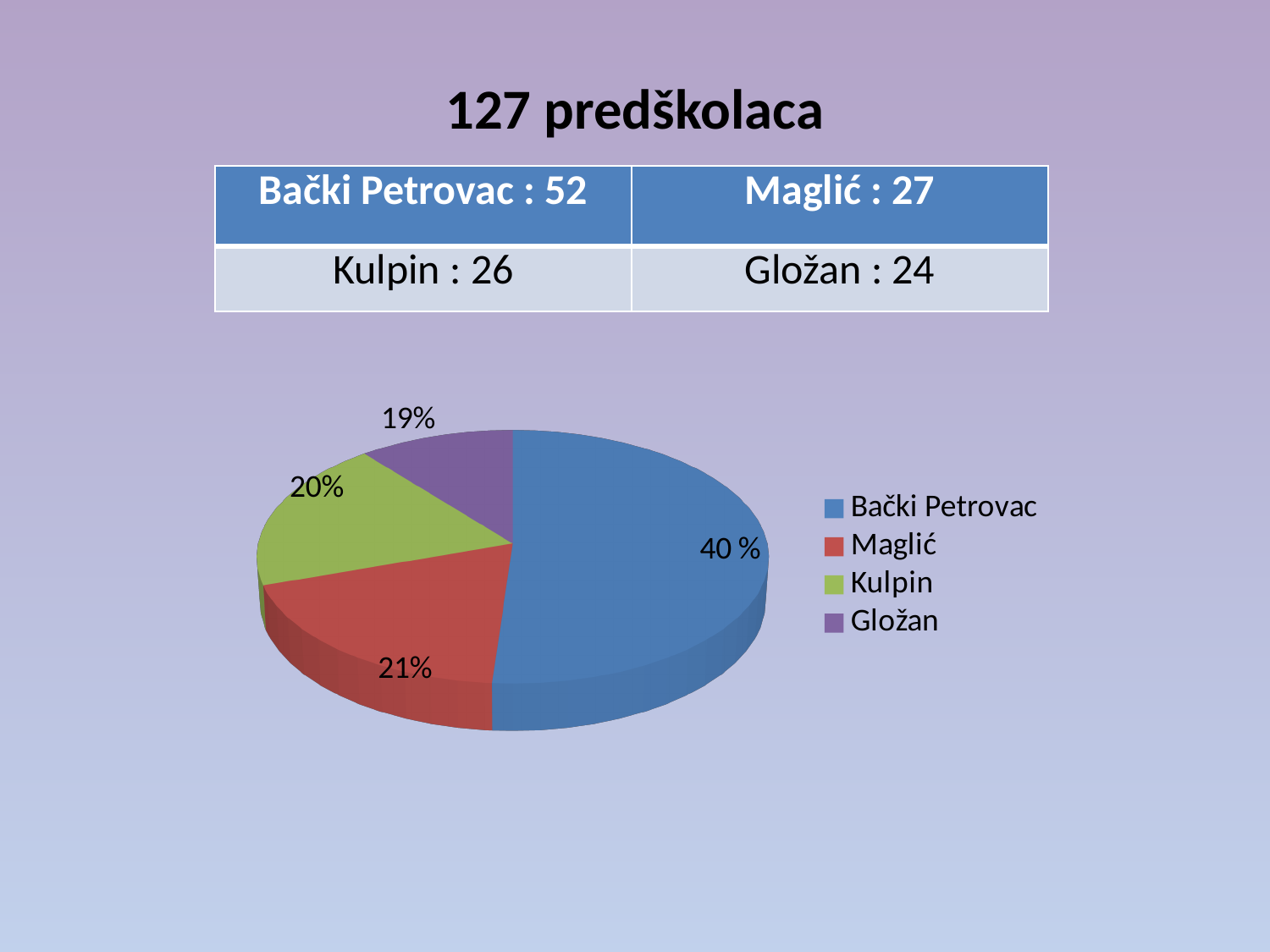
What share of the pie does Bački Petrovac have? 40 % What share of the pie does Kulpin have? 20% What kind of chart is shown on the slide? pie chart What colour is the Kulpin slice in the pie chart? green Which category has the largest slice of the pie? Bački Petrovac What share of the pie does Maglić have? 21% What colour is the Gložan slice in the pie chart? purple Which category has the smallest slice of the pie? Gložan How many slices does the pie chart have? 4 How many entries does the legend list? 4 Which slice is larger, Bački Petrovac or Maglić? Bački Petrovac